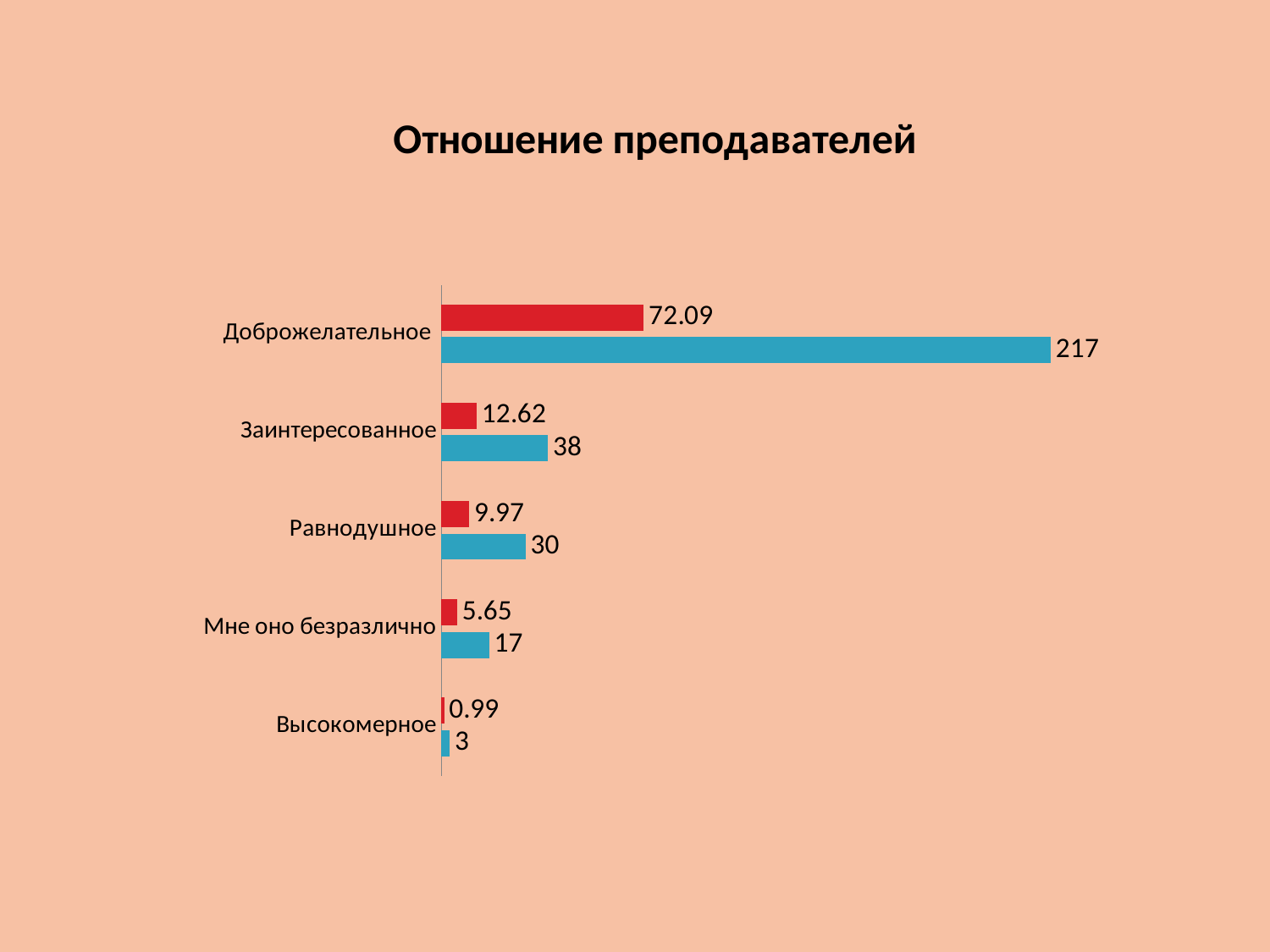
How many categories are shown on the chart? 5 What is the value of the blue bar for Равнодушное? 30 What is the title of the chart? Отношение преподавателей Which is larger, the red bar value for Равнодушное or for Мне оно безразлично? Равнодушное What is the difference between the blue bar values for Заинтересованное and Равнодушное? 8 What is the value of the red bar for Заинтересованное? 12.62 Which category has the lowest red bar value? Высокомерное What is the difference between the blue bar values for Доброжелательное and Мне оно безразлично? 200 What is the value of the red bar for Высокомерное? 0.99 What kind of chart is shown on the slide? Bar chart What is the value of the blue bar for Доброжелательное? 217 Which category has the highest blue bar value? Доброжелательное